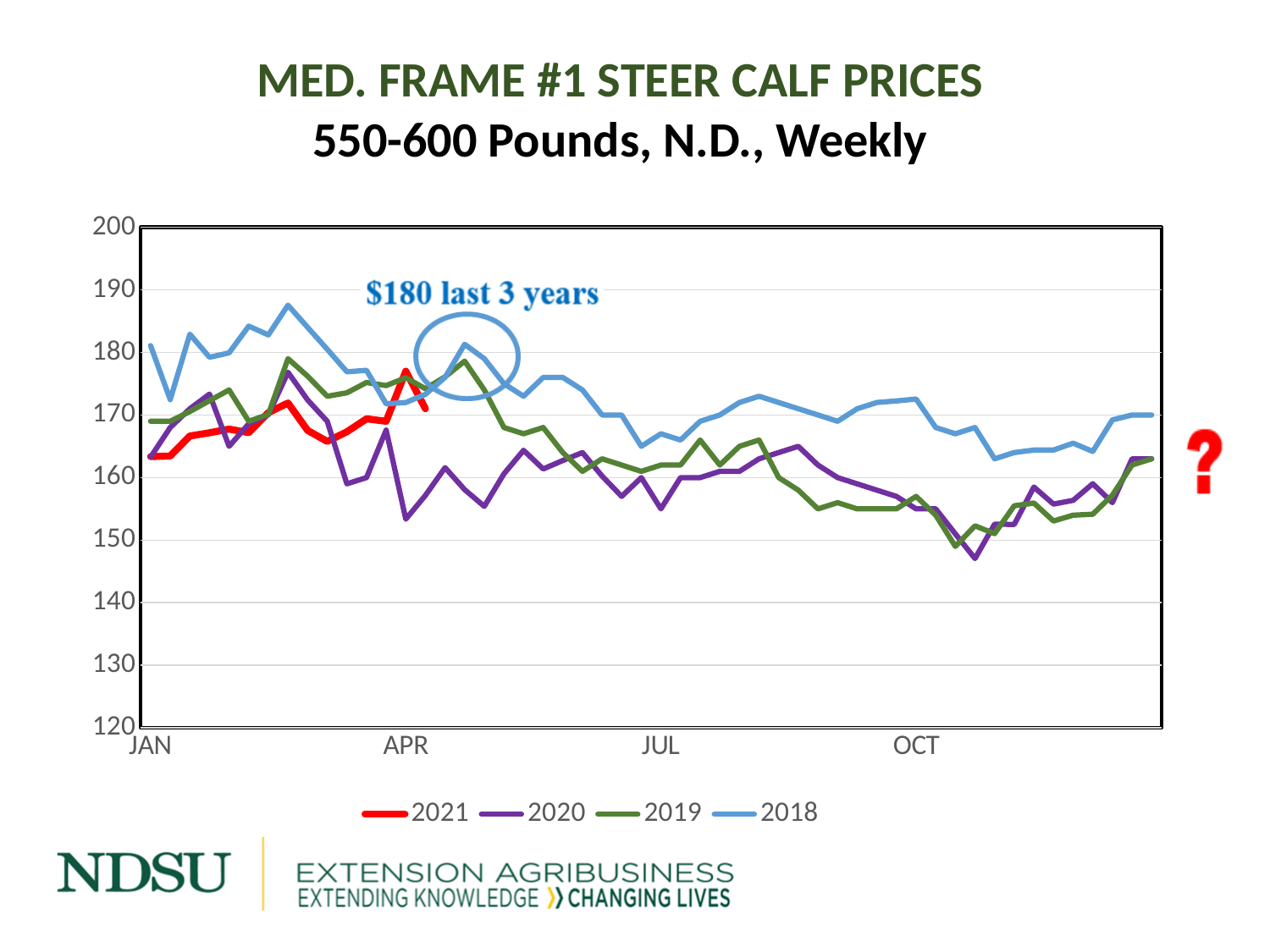
Between 2018 and 2020, which series is higher in mid-April? 2018 Is the value for 2021 at the start of January greater or less than 160? greater Is the value for 2018 at the start of January greater or less than 170? greater What kind of chart is shown on the slide? line chart Is the lowest value for 2020 (around November) greater or less than 150? less Which series has the highest value at the start of January? 2018 Which years are listed in the legend? 2021, 2020, 2019, 2018 Which series reaches the highest value anywhere on the chart? 2018 Which series reaches the lowest value anywhere on the chart? 2020 How many series does the legend list? 4 What does the annotation near the circled area in April say? $180 last 3 years